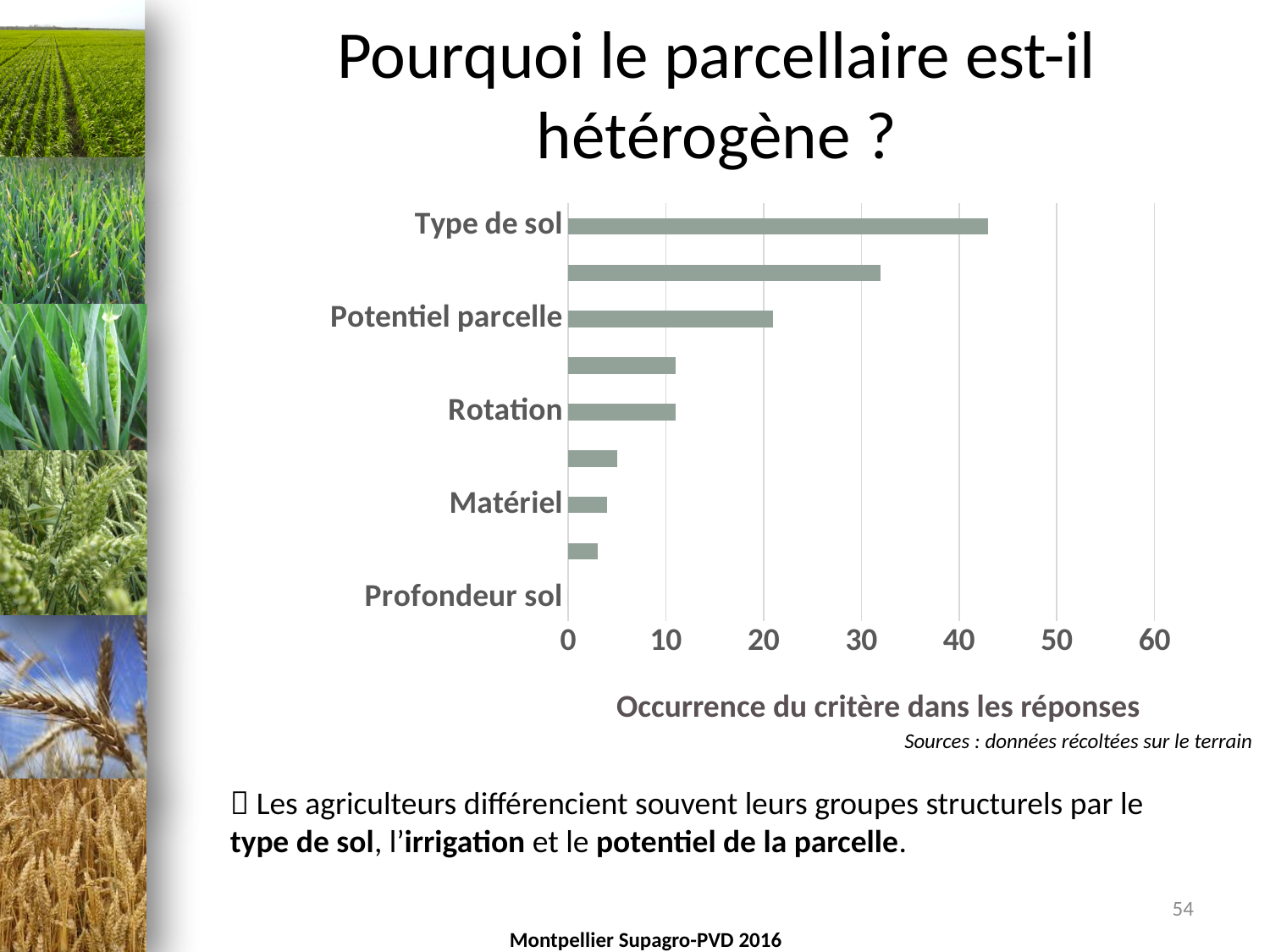
What kind of chart is shown on the slide? bar chart Is the value for Type de sol greater or less than 40? greater What is the highest value shown on the horizontal axis of the chart? 60 Is the value for Rotation greater or less than 20? less Which labelled category has the highest occurrence in the chart? Type de sol Which is larger, the value for Potentiel parcelle or the value for Rotation? Potentiel parcelle Is the value for Potentiel parcelle greater or less than 30? less Do the bar values increase or decrease going from the top of the chart to the bottom? decrease Which is larger, the value for Rotation or the value for Matériel? Rotation What is the title of the horizontal axis of the chart? Occurrence du critère dans les réponses